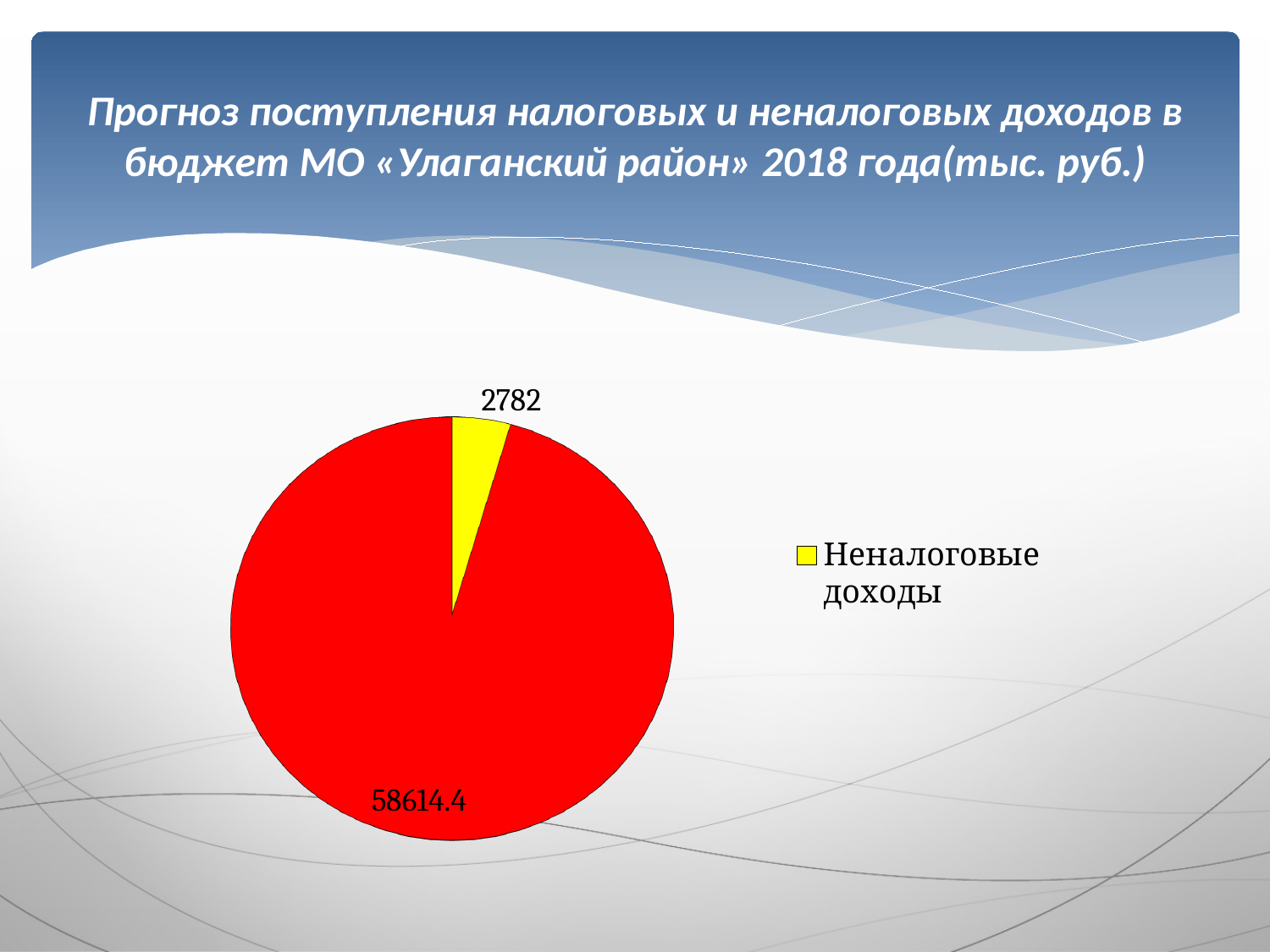
How many entries does the legend list? 1 What value is printed on the red slice of the pie chart? 58614.4 Which slice of the pie chart is the smallest? Неналоговые доходы (2782) Is the value for Неналоговые доходы larger or smaller than the value of the red slice? smaller What value is shown for Неналоговые доходы? 2782 What colour is the slice for Неналоговые доходы? yellow What is the total of the two values shown on the pie chart? 61396.4 How many slices does the pie chart have? 2 Which slice of the pie chart is the largest? the red slice (58614.4) What year does the chart title refer to? 2018 What is the difference between the red slice value and the Неналоговые доходы value? 55832.4 What kind of chart is shown on the slide? pie chart